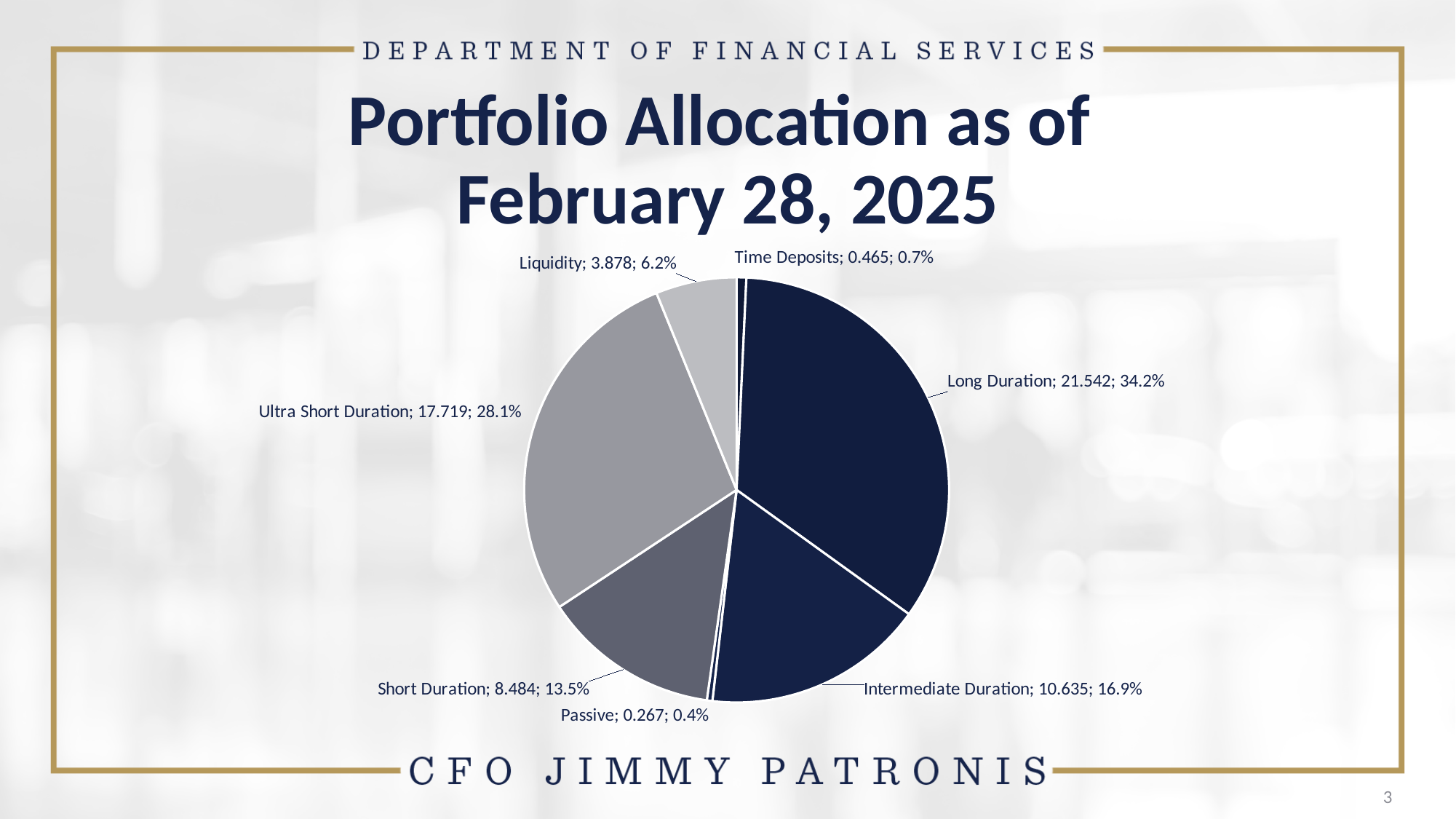
What percentage share does Ultra Short Duration have? 28.1% Which category has the largest slice of the pie? Long Duration What is the difference between the values for Long Duration and Ultra Short Duration? 3.823 What is the title of the chart? Portfolio Allocation as of February 28, 2025 What is the value shown for Long Duration? 21.542 Which category has the smallest slice of the pie? Passive Which is larger, Short Duration or Intermediate Duration? Intermediate Duration How many categories are shown in the pie chart? 7 What kind of chart is shown on the slide? Pie chart What is the value shown for Time Deposits? 0.465 What is the value shown for Intermediate Duration? 10.635 What percentage share does Liquidity have? 6.2%